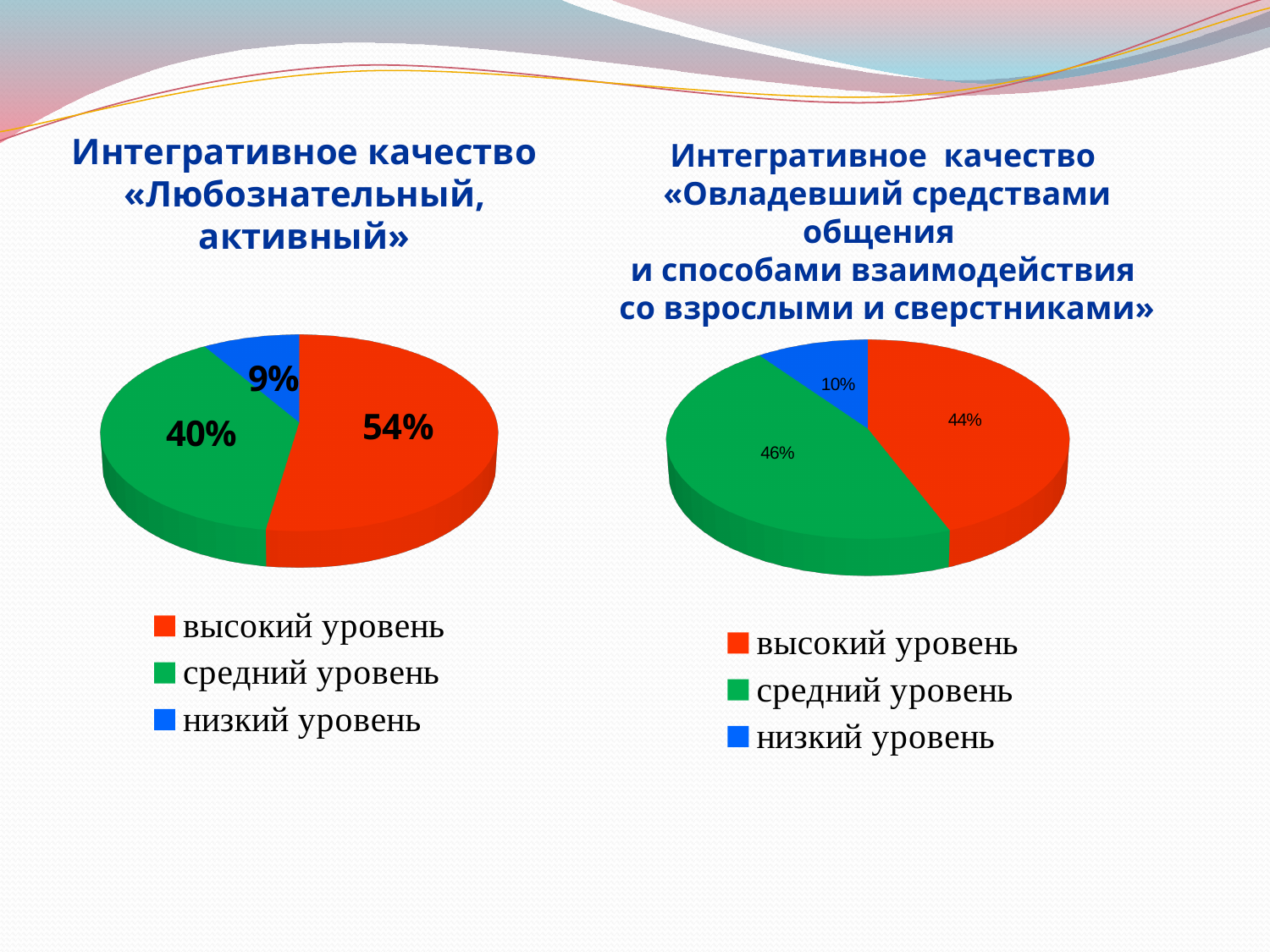
In the left chart «Любознательный, активный», what share is labelled for высокий уровень? 54% In the right chart «Овладевший средствами общения...», which level has the smallest slice? низкий уровень In the right chart «Овладевший средствами общения...», which is larger: высокий уровень or средний уровень? средний уровень In the right chart «Овладевший средствами общения...», what share is labelled for высокий уровень? 44% In the left chart «Любознательный, активный», what share is labelled for средний уровень? 40% In the left chart «Любознательный, активный», which level has the largest slice? высокий уровень In the right chart «Овладевший средствами общения...», what share is labelled for низкий уровень? 10% In the right chart «Овладевший средствами общения...», what share is labelled for средний уровень? 46% What type of chart is the left chart «Любознательный, активный»? pie chart How many entries does the legend of the right chart «Овладевший средствами общения...» list? 3 In the left chart «Любознательный, активный», what is the difference between the высокий уровень and средний уровень shares? 14% In the left chart «Любознательный, активный», what share is labelled for низкий уровень? 9%